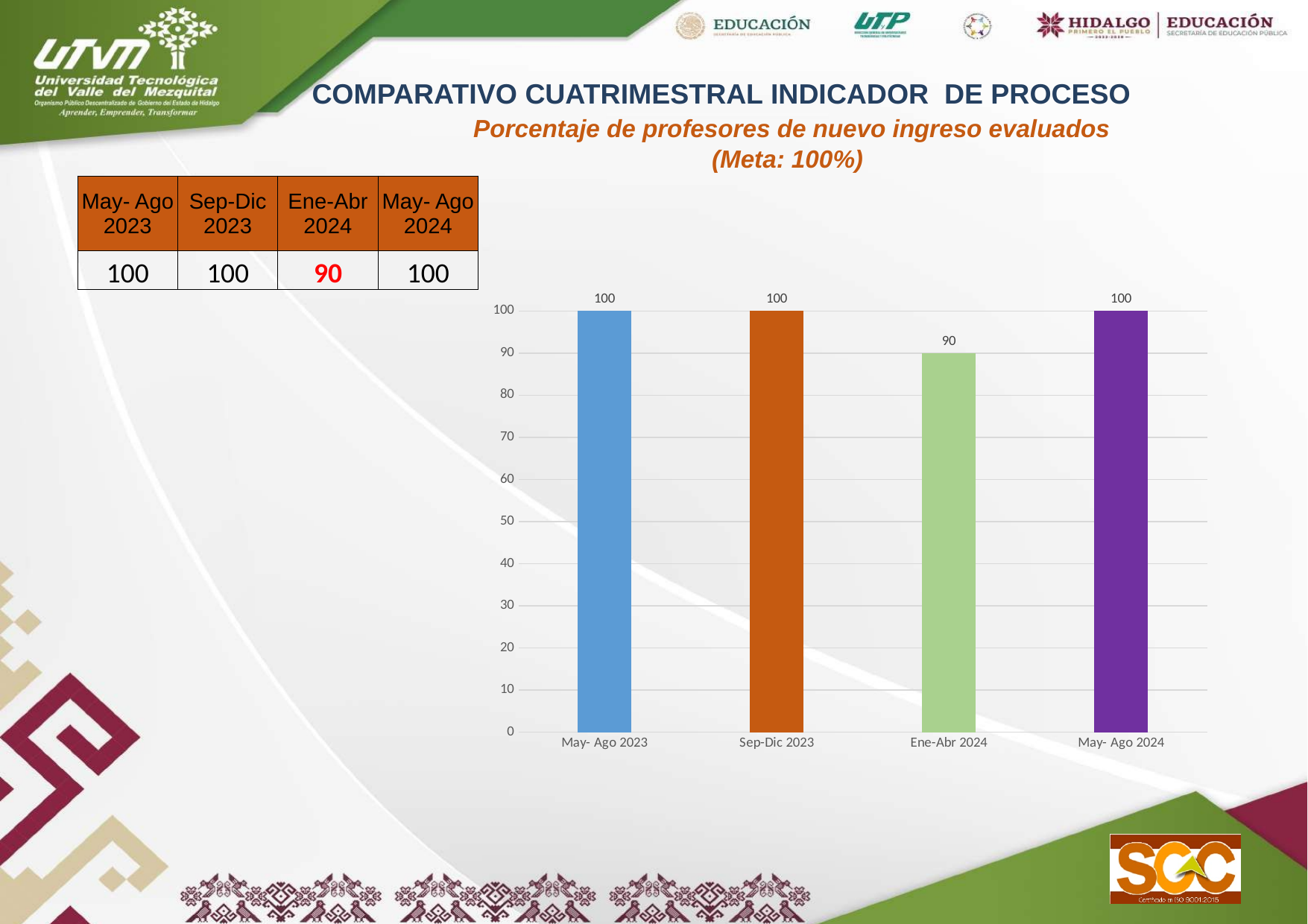
What is the target (Meta) stated in the chart subtitle? 100% What is the value for May- Ago 2024? 100 What colour is the bar for Ene-Abr 2024? green What is the difference between the values for Sep-Dic 2023 and Ene-Abr 2024? 10 Does the value rise or fall from Sep-Dic 2023 to Ene-Abr 2024? fall Is the value for Ene-Abr 2024 greater or less than 100? less How many periods are shown on the x axis? 4 What kind of chart is shown? bar chart Which is larger, the value for May- Ago 2023 or the value for Ene-Abr 2024? May- Ago 2023 What is the value for Sep-Dic 2023? 100 Which period has the lowest value? Ene-Abr 2024 What is the value for Ene-Abr 2024? 90